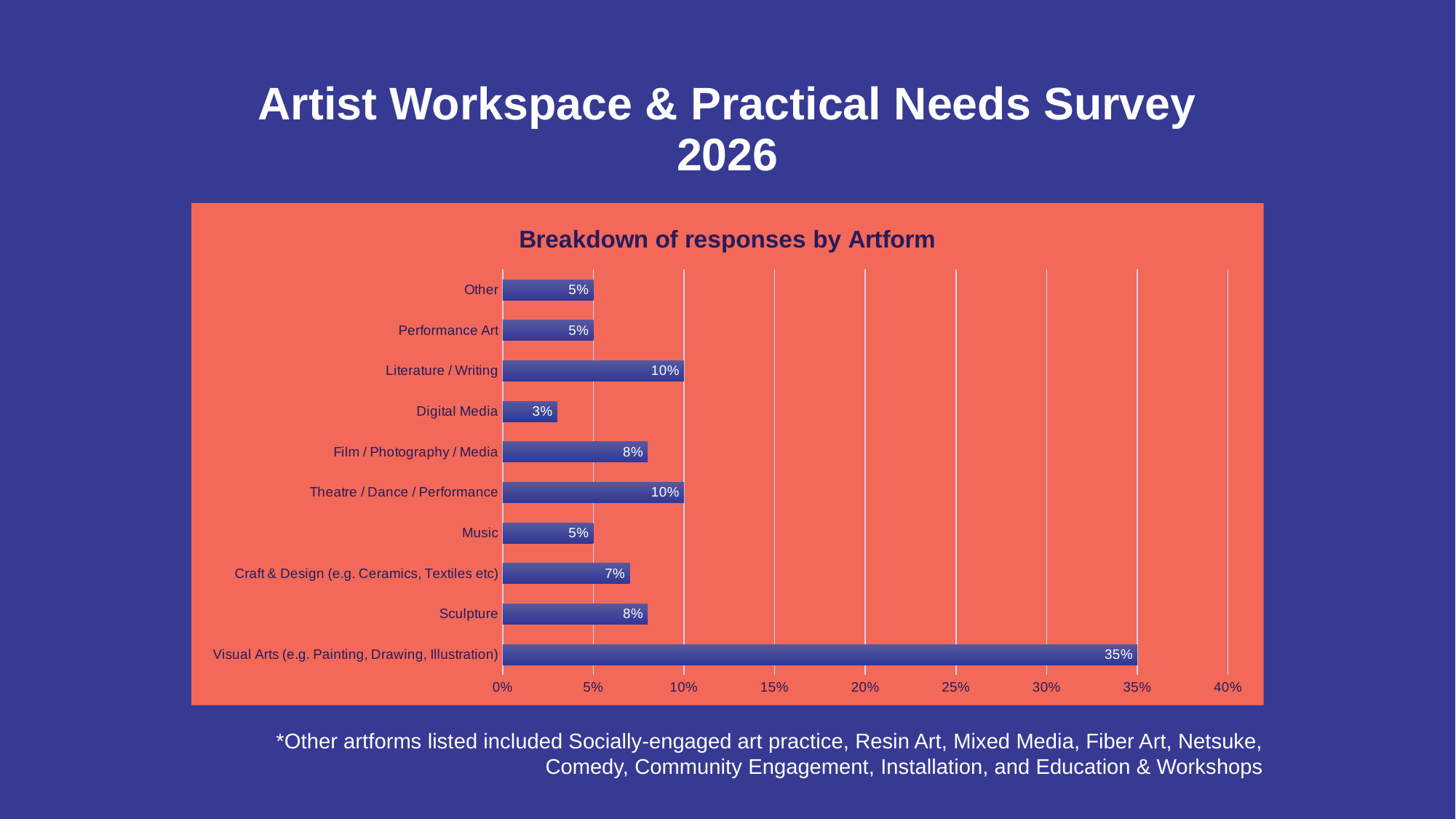
What is the difference between the values for Literature / Writing and Music? 5% What is the value for Craft & Design (e.g. Ceramics, Textiles etc)? 7% What percentage of responses is shown for Visual Arts (e.g. Painting, Drawing, Illustration)? 35% Which artform has the highest share of responses? Visual Arts (e.g. Painting, Drawing, Illustration) Is the value for Theatre / Dance / Performance greater or less than 5%? greater Which is larger, the value for Film / Photography / Media or the value for Performance Art? Film / Photography / Media What is the title of the chart? Breakdown of responses by Artform What is the difference between the values for Visual Arts and Sculpture? 27% How many artform categories are shown in the chart? 10 Which artform has the lowest share of responses? Digital Media What is the value for Digital Media? 3% What kind of chart is shown on the slide? Bar chart